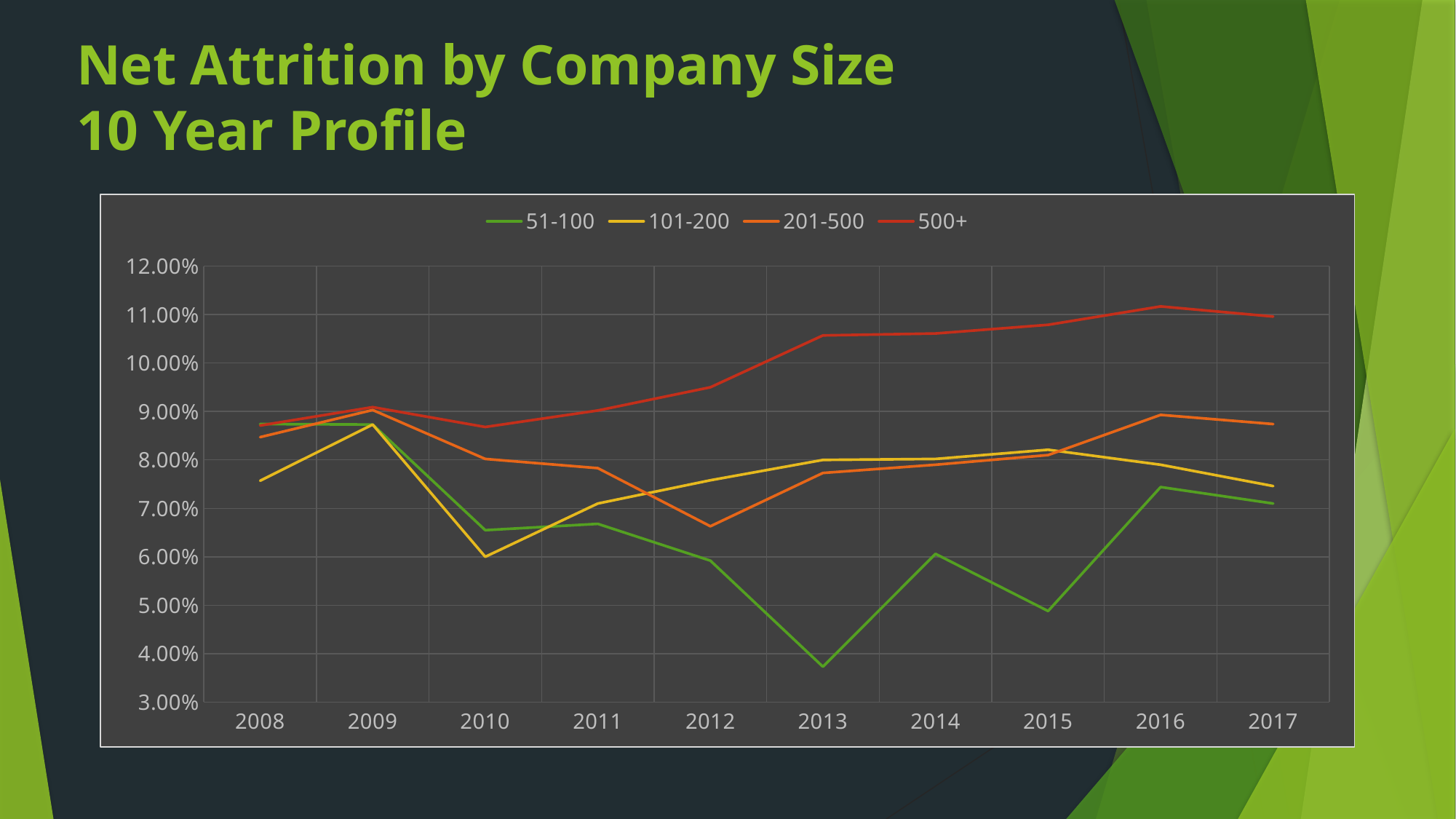
Is the value for the 101-200 series in 2010 greater or less than 7.00%? less Does the 500+ series rise or fall from 2012 to 2016? rise Is the value for the 500+ series in 2016 greater or less than 11.00%? greater In 2012, which is larger: the 101-200 series or the 201-500 series? 101-200 Is the value for the 51-100 series in 2013 greater or less than 4.00%? less In which year is the 51-100 series at its lowest? 2013 Which series has the highest value in 2017? 500+ How many years are shown on the x axis? 10 How many series does the legend list? 4 In which year is the 500+ series at its highest? 2016 Which series has the lowest value in 2015? 51-100 What kind of chart is shown on the slide? line chart